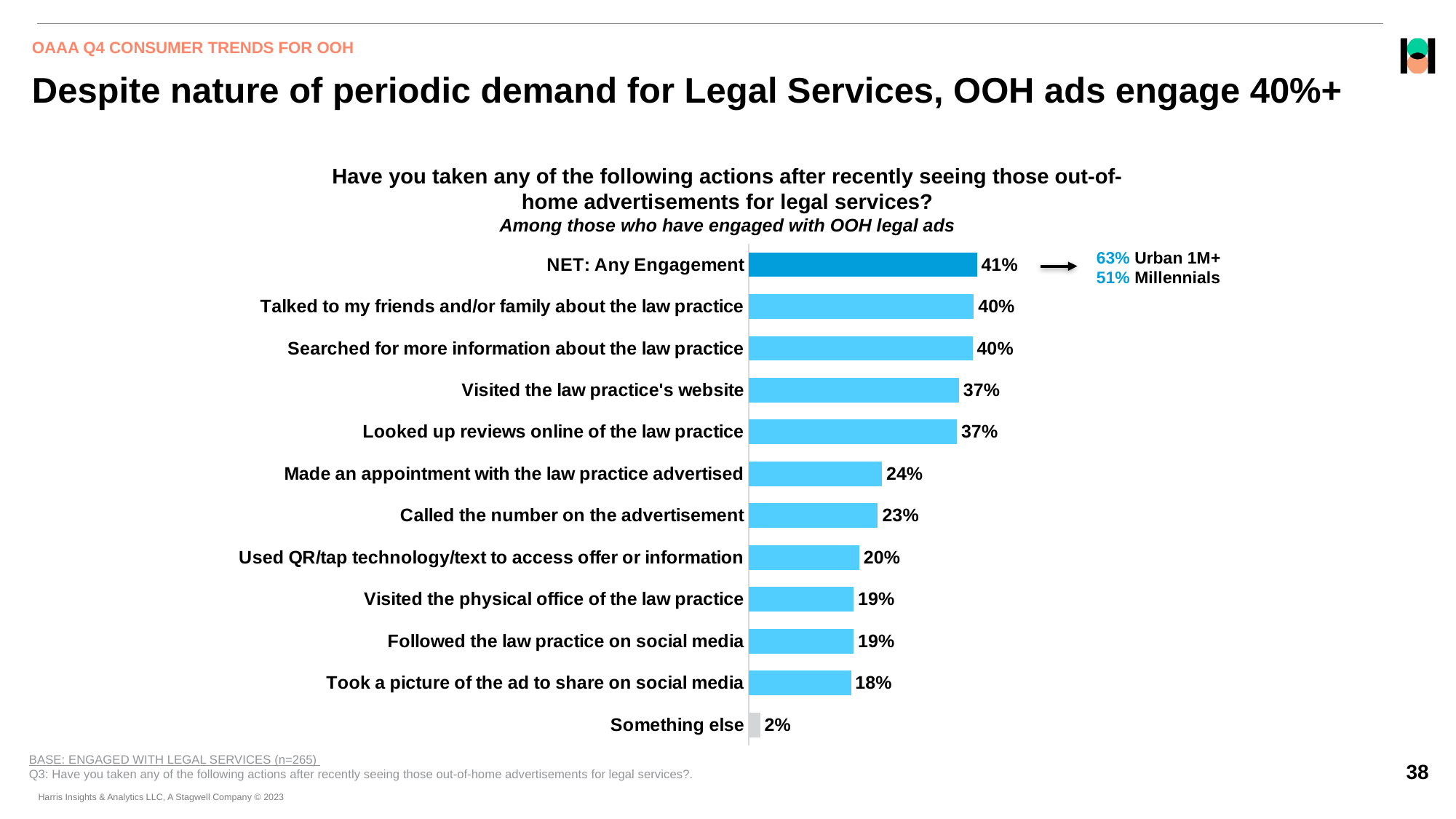
Which is larger: 'Looked up reviews online of the law practice' or 'Called the number on the advertisement'? Looked up reviews online of the law practice How many categories are plotted in the chart? 12 What is the difference between 'Made an appointment with the law practice advertised' and 'Used QR/tap technology/text to access offer or information'? 4 percentage points Excluding the NET bar, which action has the highest value? Talked to my friends and/or family about the law practice and Searched for more information about the law practice (both 40%) What is the sample size (n) stated in the base note of the chart? 265 What percentage of respondents took a picture of the ad to share on social media? 18% What type of chart is shown on the slide? Bar chart Which category has the lowest value in the chart? Something else According to the annotation next to the NET bar, what is the engagement rate for Millennials? 51% What percentage is shown for 'NET: Any Engagement'? 41% What percentage of respondents called the number on the advertisement? 23% What percentage of respondents visited the law practice's website? 37%